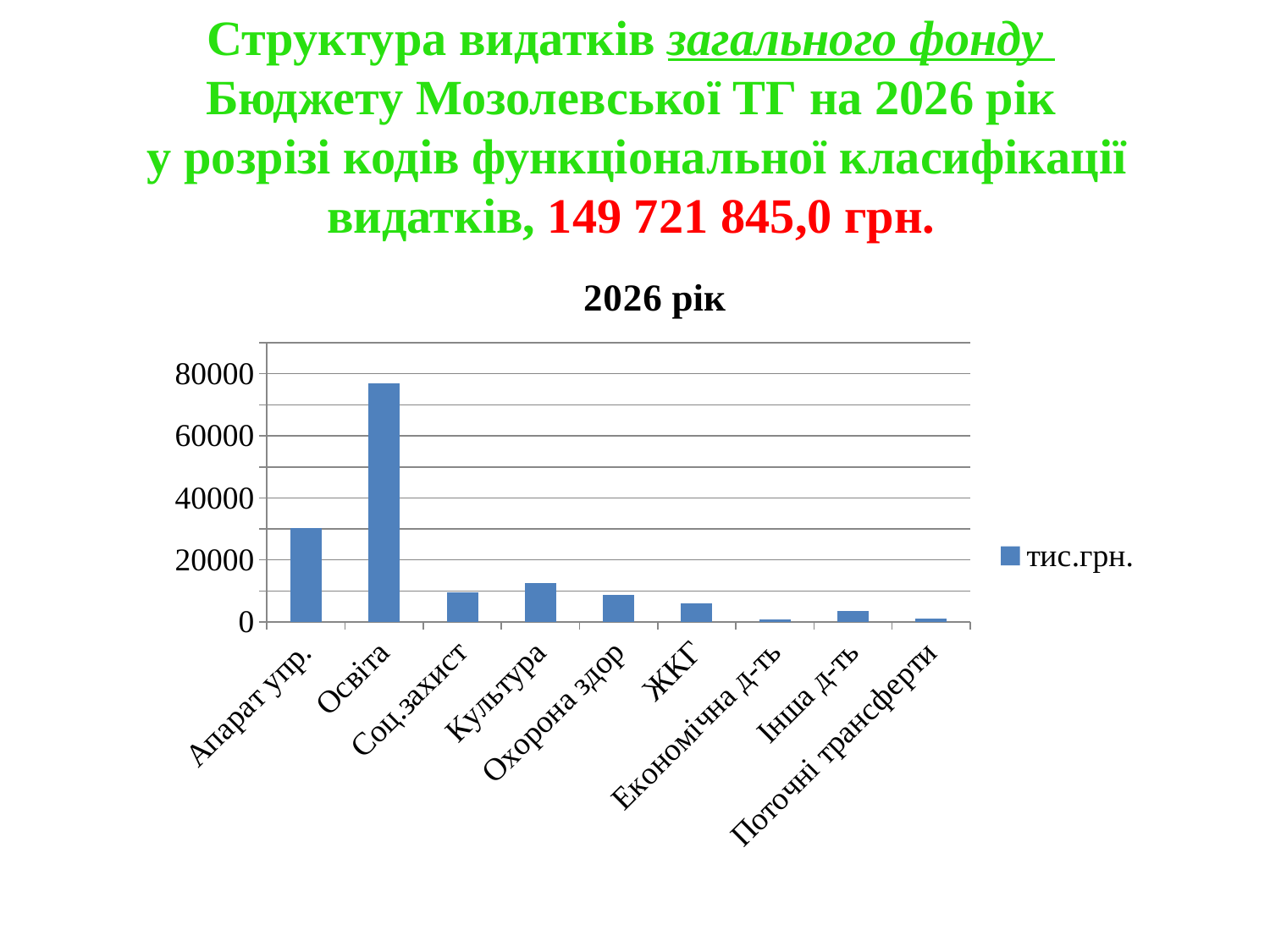
Is the value for Культура greater or less than 20000? less Is the value for Апарат упр. greater or less than 40000? less Which category has the highest value in the chart? Освіта What kind of chart is shown on the slide? bar chart Is the value for Освіта greater or less than 60000? greater Which is larger, the value for Апарат упр. or the value for Соц.захист? Апарат упр. Which is larger, the value for Культура or the value for ЖКГ? Культура What is the title of the chart? 2026 рік How many series does the chart legend list? 1 How many categories are shown on the x axis of the chart? 9 What is the name of the series shown in the chart legend? тис.грн.